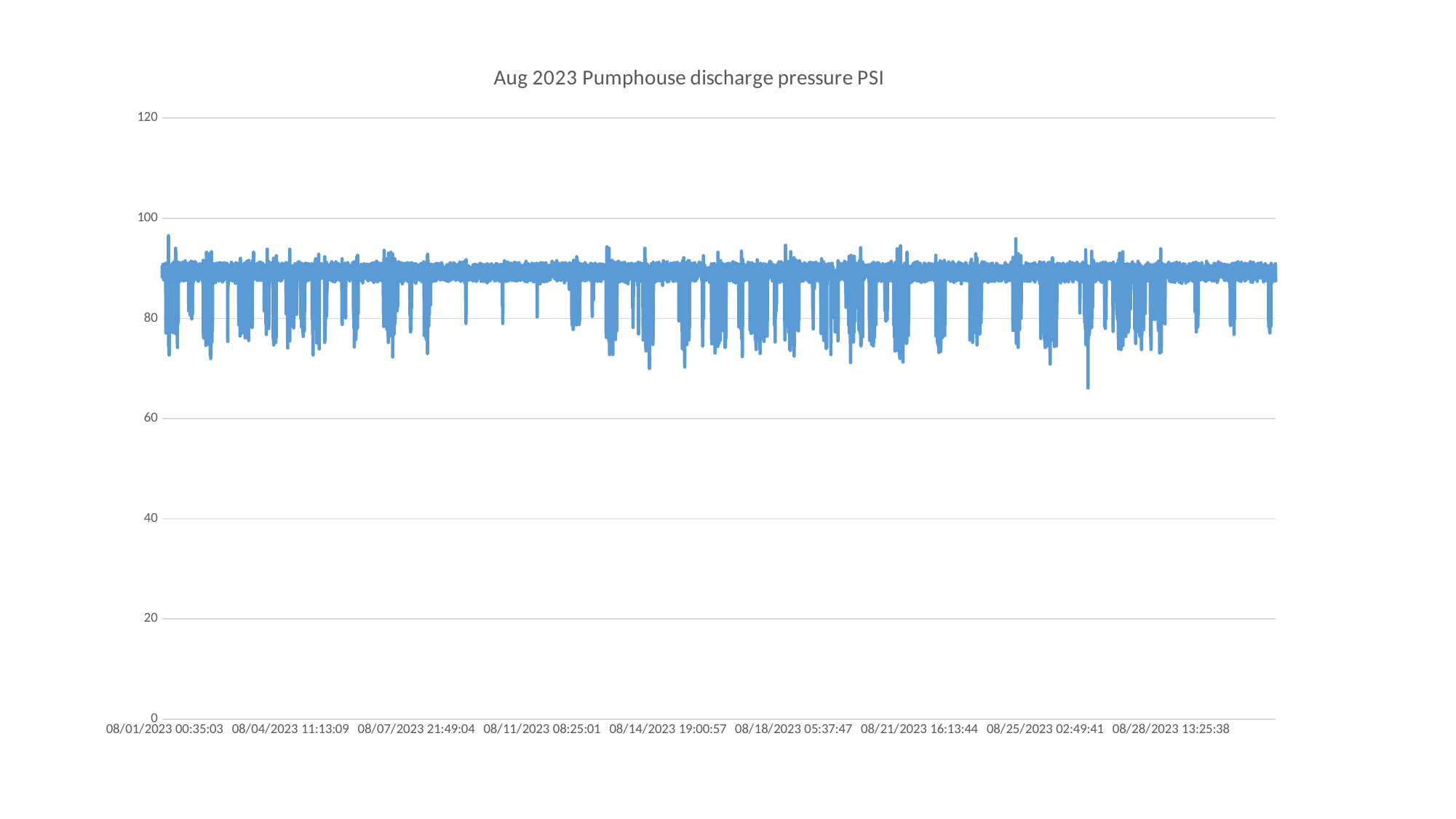
What is the first date label on the horizontal axis? 08/01/2023 00:35:03 Is the pressure value at the end of the series greater or less than 100? less Is the pressure value at the start of the series (08/01/2023 00:35:03) greater or less than 80? greater Overall, does the pressure level rise, fall, or stay roughly flat across August 2023? roughly flat Is the lowest dip in the pressure line greater or less than 60? greater What is the title of the chart? Aug 2023 Pumphouse discharge pressure PSI What is the highest value shown on the vertical axis? 120 What kind of chart is shown on the slide? line chart How many date labels are printed along the horizontal axis? 9